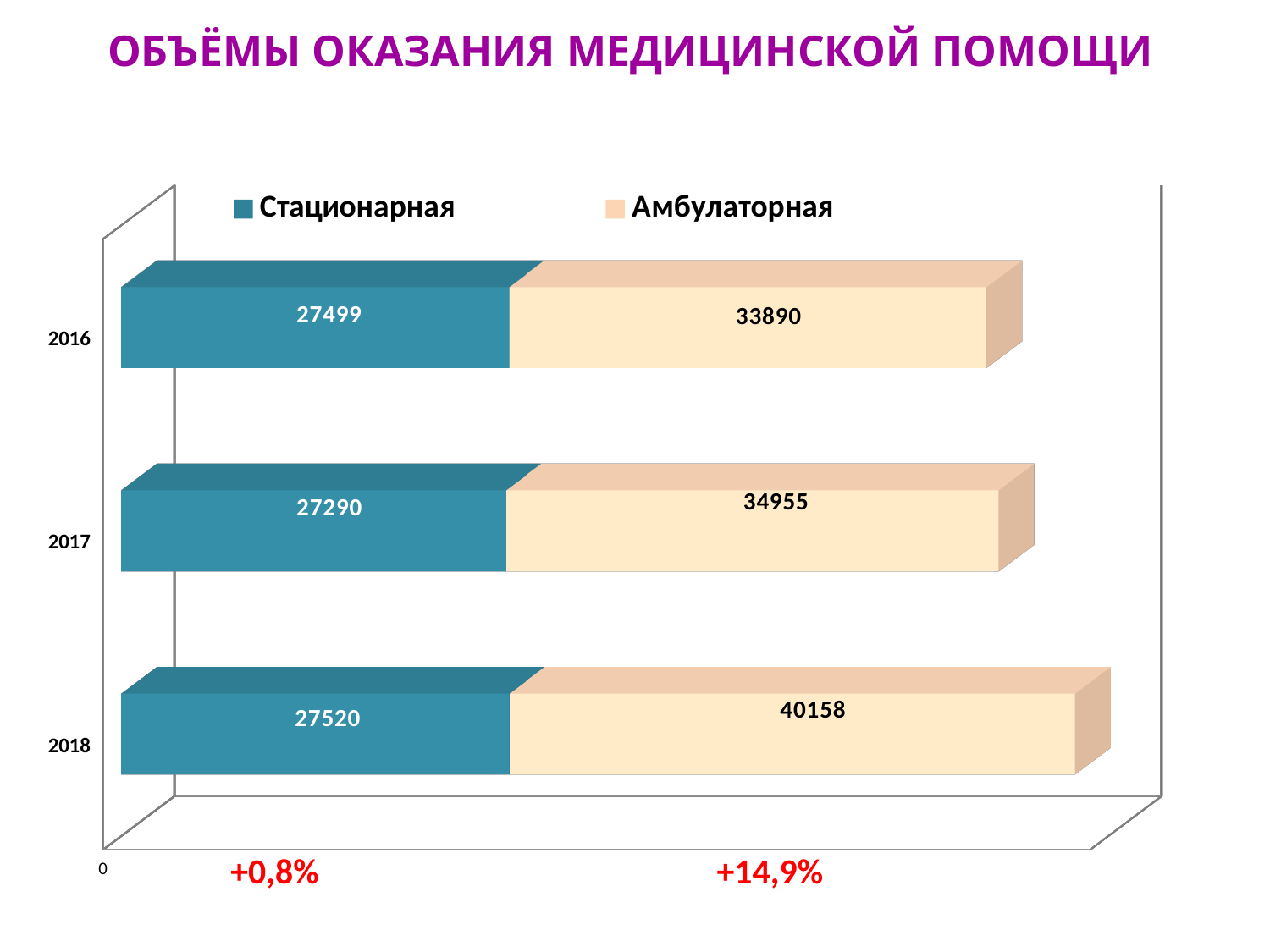
What is the total of the stacked bar for 2018? 67678 What kind of chart is shown on the slide? Stacked bar chart What is the title of the chart? ОБЪЁМЫ ОКАЗАНИЯ МЕДИЦИНСКОЙ ПОМОЩИ What is the value for Стационарная in 2016? 27499 What is the value for Амбулаторная in 2017? 34955 What is the difference between the Амбулаторная values for 2018 and 2016? 6268 Which is larger in 2017: Стационарная or Амбулаторная? Амбулаторная How many years are shown on the chart? 3 In which year is the Амбулаторная value highest? 2018 How many series does the legend list? 2 In which year is the Стационарная value lowest? 2017 What is the value for Амбулаторная in 2018? 40158